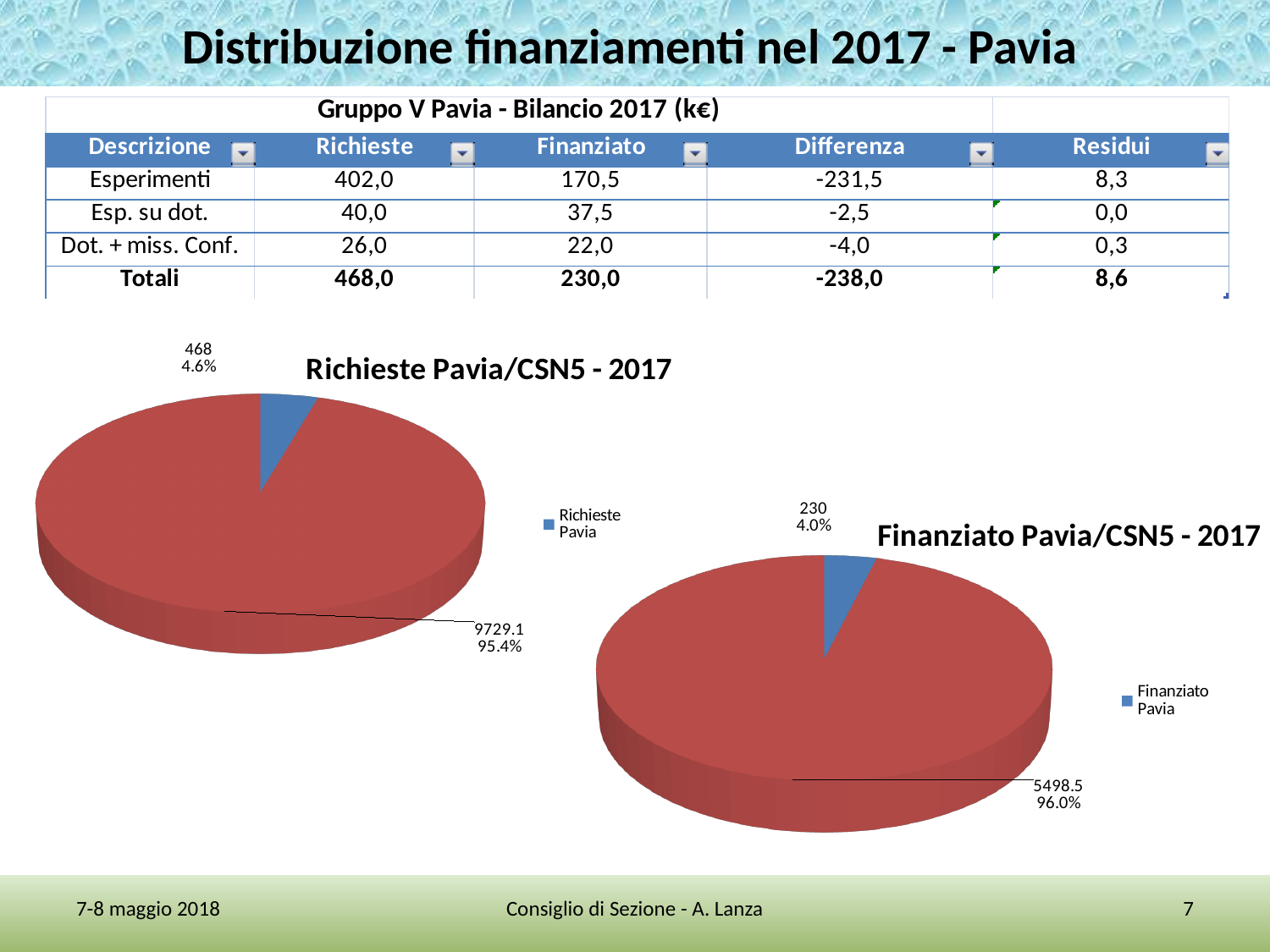
In the "Finanziato Pavia/CSN5 - 2017" chart, what percentage share does the large red slice have? 96.0% What type of chart is the "Richieste Pavia/CSN5 - 2017" chart? pie chart What is the title of the pie chart on the right side of the slide? Finanziato Pavia/CSN5 - 2017 In the "Richieste Pavia/CSN5 - 2017" chart, which slice is larger, the blue Richieste Pavia slice or the red slice? the red slice How many slices does the "Finanziato Pavia/CSN5 - 2017" pie chart have? 2 In the "Richieste Pavia/CSN5 - 2017" chart, what value is shown for the Richieste Pavia slice? 468 In the "Finanziato Pavia/CSN5 - 2017" chart, what percentage share does the Finanziato Pavia slice have? 4.0% In the "Richieste Pavia/CSN5 - 2017" chart, what value is shown for the large red slice? 9729.1 In the "Richieste Pavia/CSN5 - 2017" chart, what percentage share does the large red slice have? 95.4% In the "Finanziato Pavia/CSN5 - 2017" chart, what value is shown for the Finanziato Pavia slice? 230 In the "Finanziato Pavia/CSN5 - 2017" chart, what value is shown for the large red slice? 5498.5